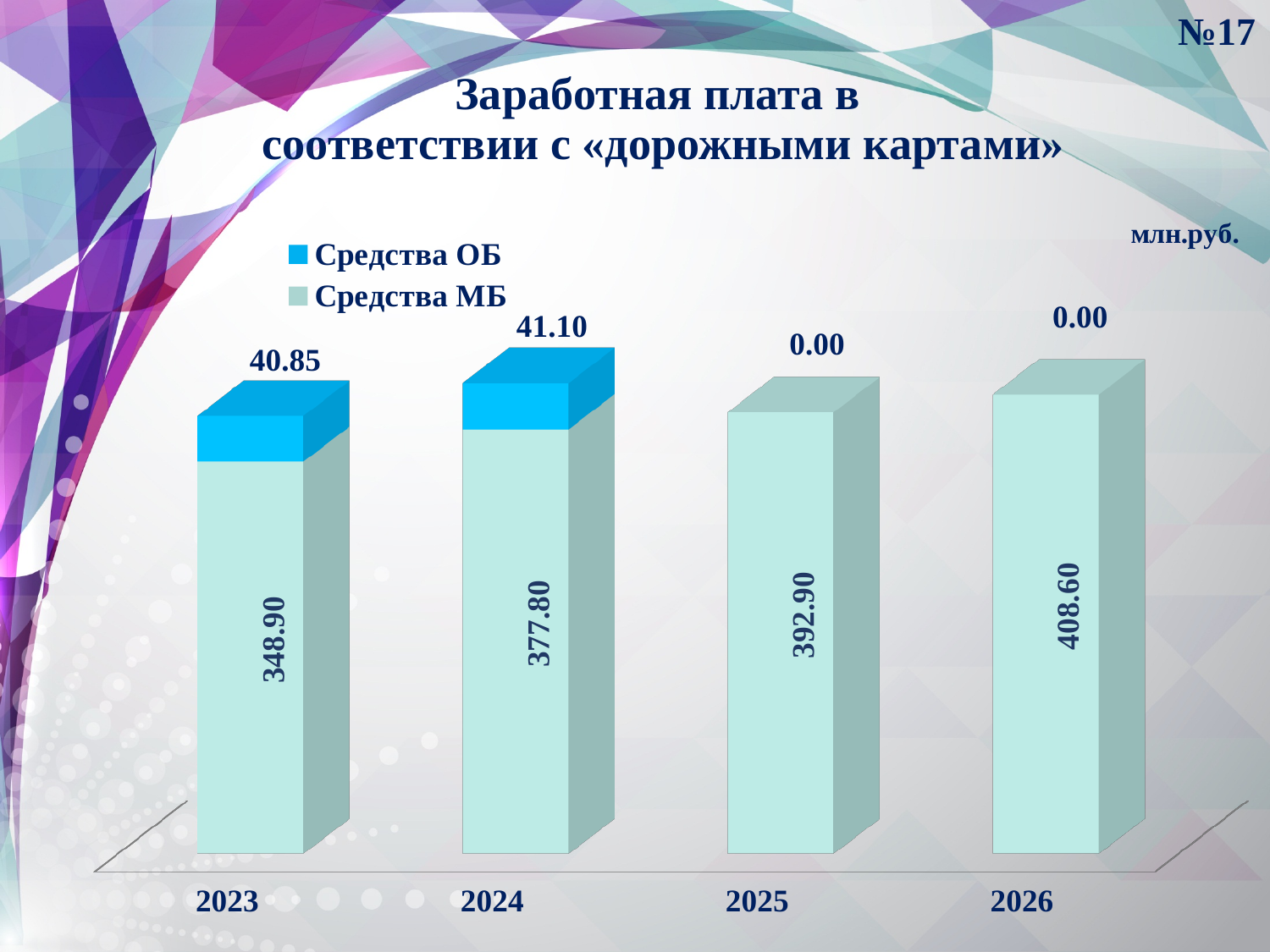
What is the difference between Средства МБ in 2024 and in 2023? 28.90 Which is larger, Средства ОБ in 2023 or in 2024? 2024 What is the total of the stacked bar for 2024? 418.90 Which year has the lowest value for Средства МБ? 2023 How many series does the legend list? 2 What is the value of Средства ОБ for 2024? 41.10 What is the value of Средства МБ for 2023? 348.90 What is the value of Средства ОБ for 2025? 0.00 What kind of chart is shown on the slide? Stacked bar chart What is the value of Средства МБ for 2026? 408.60 Which year has the highest value for Средства МБ? 2026 How many years are shown on the x axis? 4